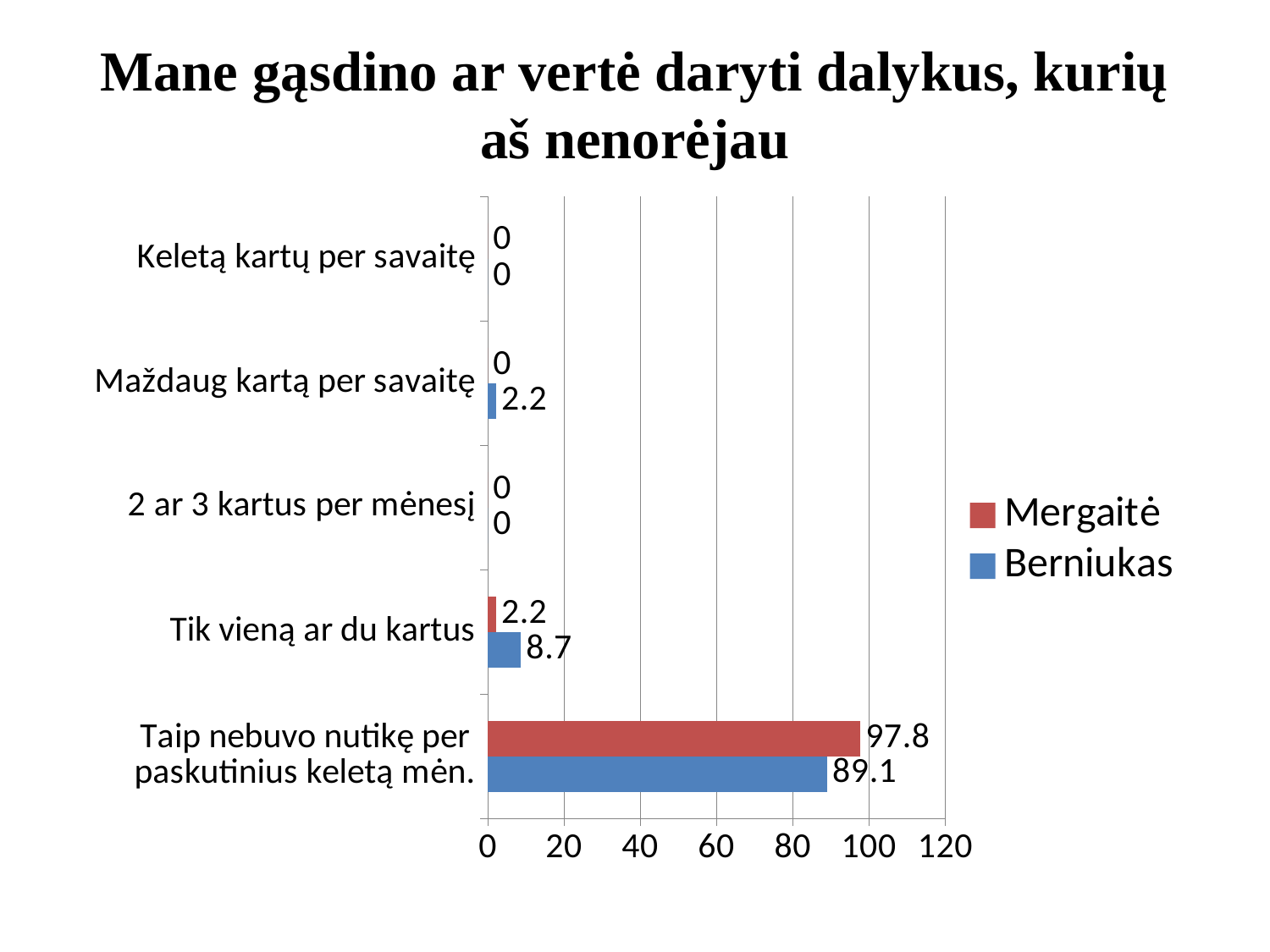
How many series does the legend list? 2 What is the Berniukas value for "Maždaug kartą per savaitę"? 2.2 For "Tik vieną ar du kartus", which series has the larger value, Mergaitė or Berniukas? Berniukas Which category has the highest Berniukas value? Taip nebuvo nutikę per paskutinius keletą mėn. Is the Berniukas value for "Taip nebuvo nutikę per paskutinius keletą mėn." greater or less than 80? greater What is the Mergaitė value for "Taip nebuvo nutikę per paskutinius keletą mėn."? 97.8 What is the Berniukas value for "Taip nebuvo nutikę per paskutinius keletą mėn."? 89.1 How many categories are shown on the chart? 5 What is the Berniukas value for "Tik vieną ar du kartus"? 8.7 What is the Mergaitė value for "Tik vieną ar du kartus"? 2.2 What kind of chart is shown on the slide? Bar chart What is the difference between the Mergaitė and Berniukas values for "Taip nebuvo nutikę per paskutinius keletą mėn."? 8.7